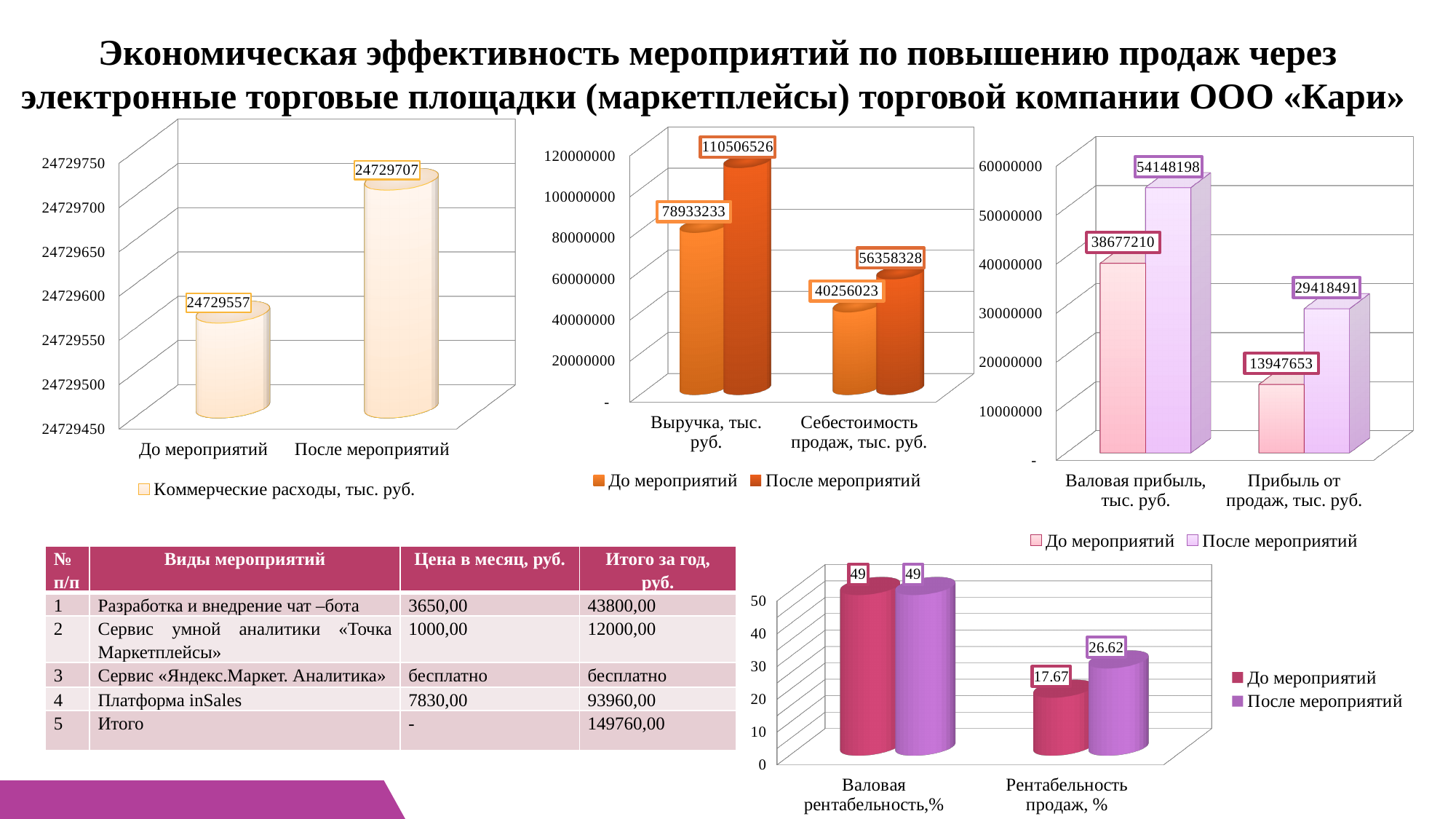
On the top-left chart (Коммерческие расходы), what is the difference between После мероприятий and До мероприятий? 150 On the bottom-right chart, what is the value of Рентабельность продаж, % for После мероприятий? 26.62 On the top-right chart, which category has the lowest value for До мероприятий? Прибыль от продаж, тыс. руб. On the top-middle chart, how many series does the legend list? 2 On the top-left chart (Коммерческие расходы), what is the value for После мероприятий? 24729707 On the top-middle chart, what is the value of Выручка, тыс. руб. for После мероприятий? 110506526 On the bottom-right chart, what is the value of Валовая рентабельность,% for До мероприятий? 49 On the top-middle chart, what is the value of Себестоимость продаж, тыс. руб. for До мероприятий? 40256023 What kind of chart is the bottom-right chart? bar chart On the top-right chart, what is the value of Валовая прибыль, тыс. руб. for После мероприятий? 54148198 On the top-right chart, what is the difference between После мероприятий and До мероприятий for Прибыль от продаж, тыс. руб.? 15470838 On the top-left chart (Коммерческие расходы), what is the value for До мероприятий? 24729557